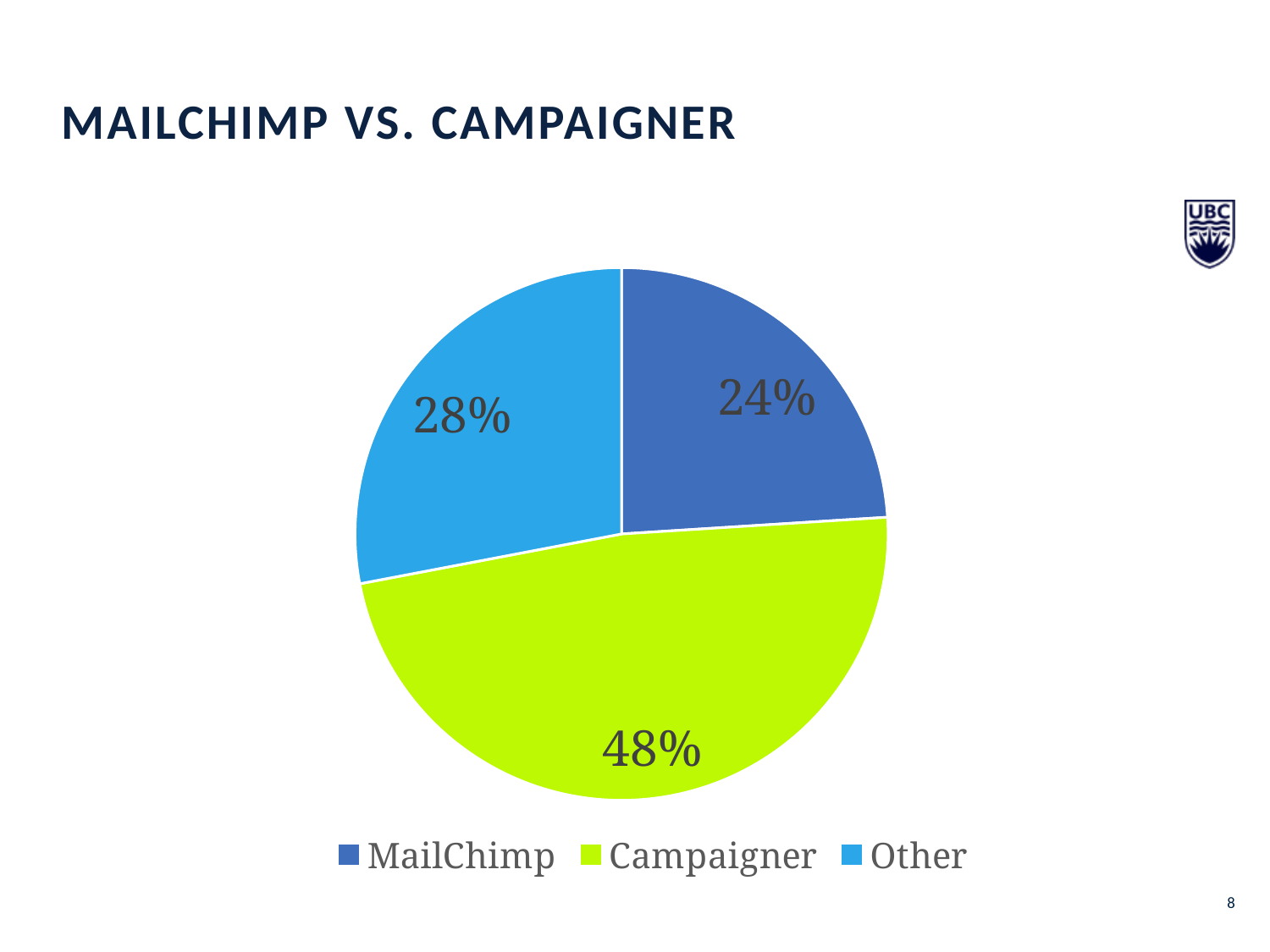
What is the title of the slide containing the pie chart? MAILCHIMP VS. CAMPAIGNER What kind of chart is shown on the slide? pie chart What colour is the Campaigner slice in the pie chart? green How many slices does the pie chart have? 3 Which is larger, the share for Other or the share for MailChimp? Other What share of the pie does Campaigner have? 48% What is the difference in percentage points between Campaigner and MailChimp? 24 Which category has the largest slice of the pie? Campaigner What share of the pie does MailChimp have? 24% What share of the pie does Other have? 28% Which category has the smallest slice of the pie? MailChimp What is the difference in percentage points between Other and MailChimp? 4